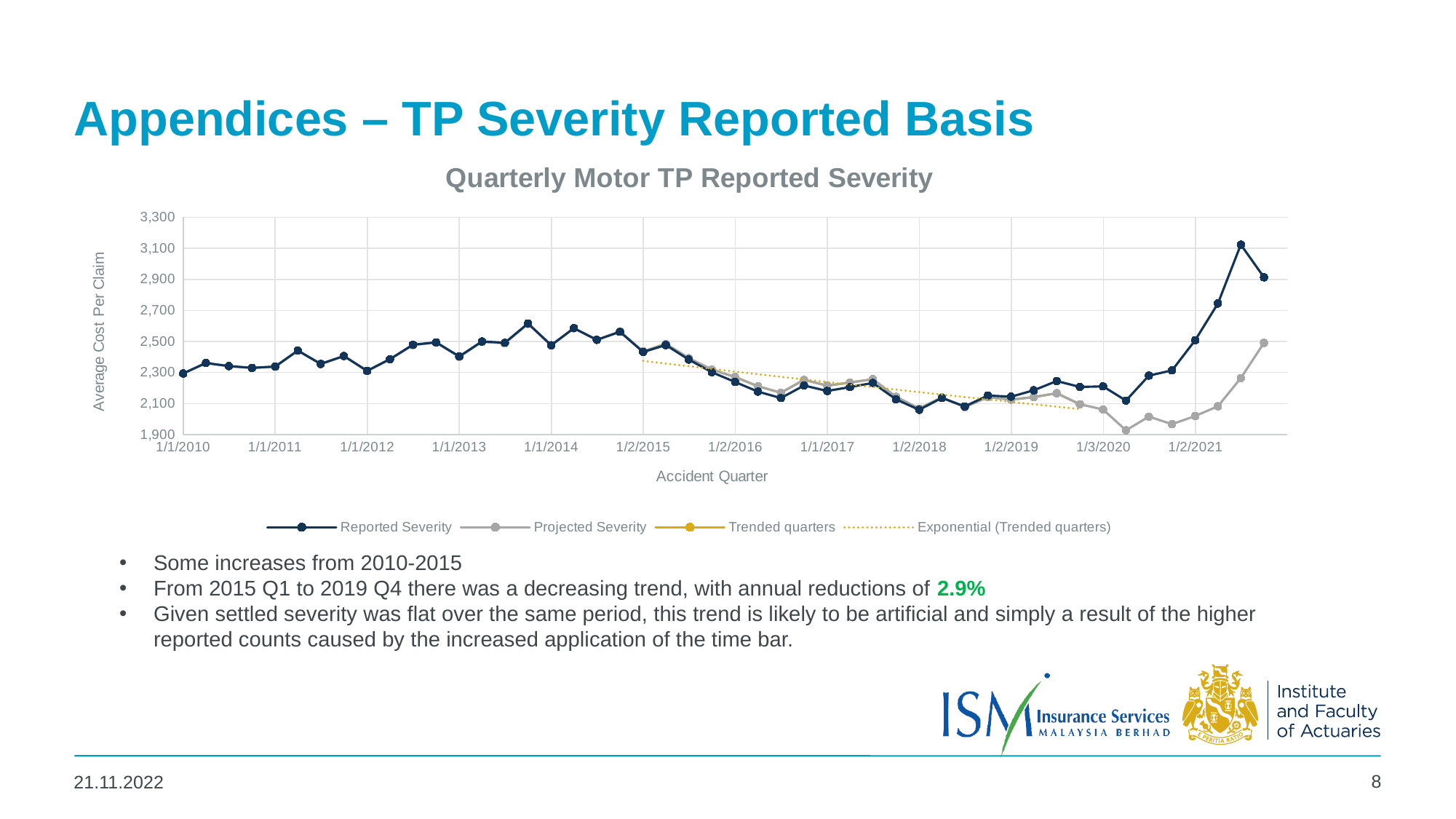
What is the title of the chart? Quarterly Motor TP Reported Severity Does the Reported Severity series rise or fall between 1/3/2020 and the peak in 2021? rise How many date labels are shown on the x axis? 12 Is the highest Reported Severity value greater or less than 2,900? greater Does the Reported Severity series generally rise or fall between 1/2/2015 and 1/2/2019? fall At the last accident quarter plotted, which series has the larger value, Reported Severity or Projected Severity? Reported Severity How many series does the chart legend list? 4 What kind of chart is shown on the slide? line chart Is the lowest Projected Severity value greater or less than 2,100? less Is the Reported Severity value at 1/1/2010 greater or less than 2,100? greater What is the label of the vertical axis? Average Cost Per Claim